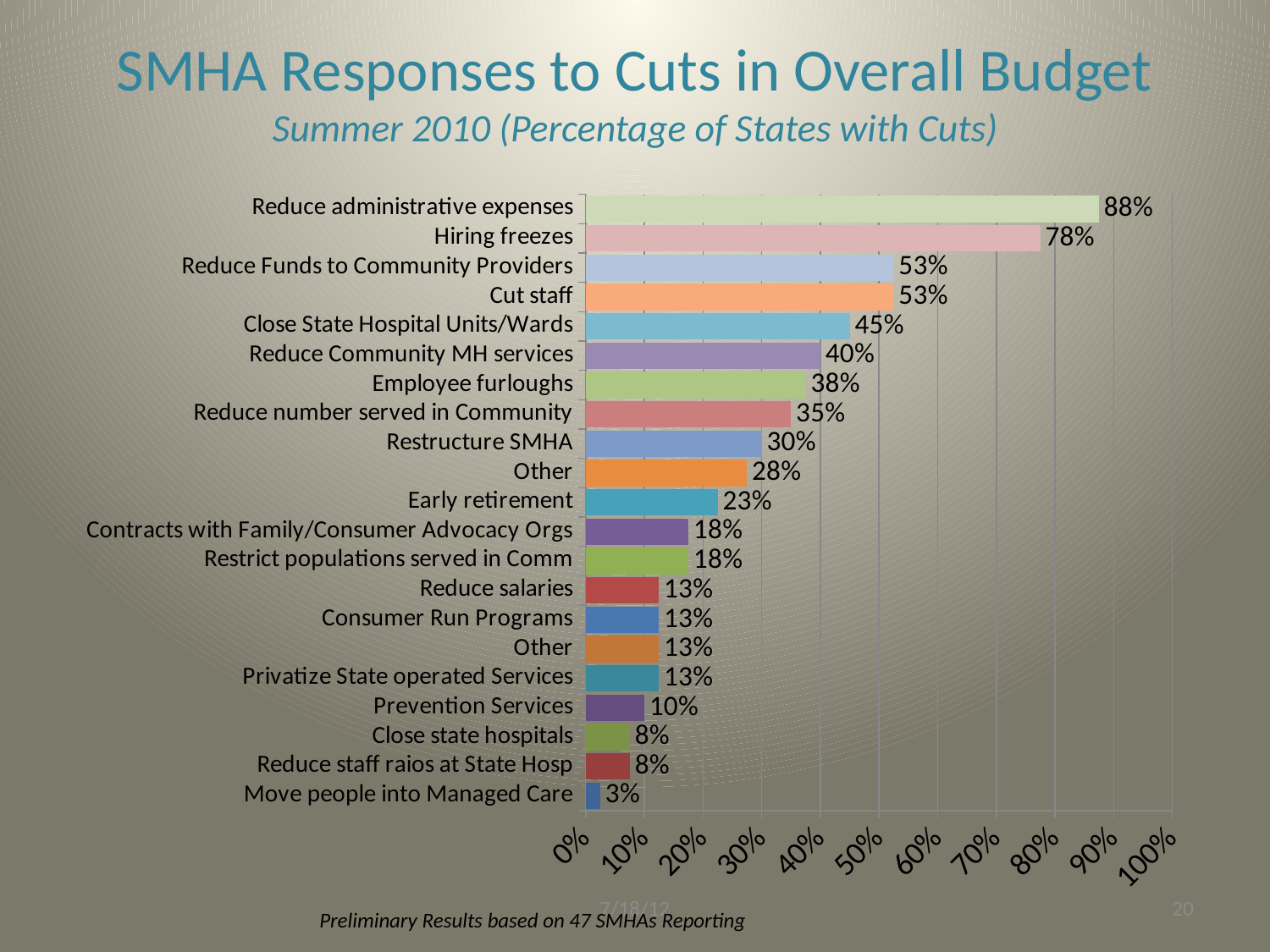
What is the value for Early retirement? 23% What percentage of states reported Employee furloughs? 38% What type of chart is shown on the slide? Bar chart How many response categories are shown in the chart? 21 What percentage of states reported reducing administrative expenses? 88% What is the difference between Close State Hospital Units/Wards and Close state hospitals? 37% What is the value for Hiring freezes? 78% What is the difference between the values for Reduce administrative expenses and Hiring freezes? 10% Which response has the lowest percentage of states with cuts? Move people into Managed Care Which response has the highest percentage of states with cuts? Reduce administrative expenses Is the value for Reduce Community MH services greater or less than 50%? less Which is larger, the value for Restructure SMHA or the value for Prevention Services? Restructure SMHA